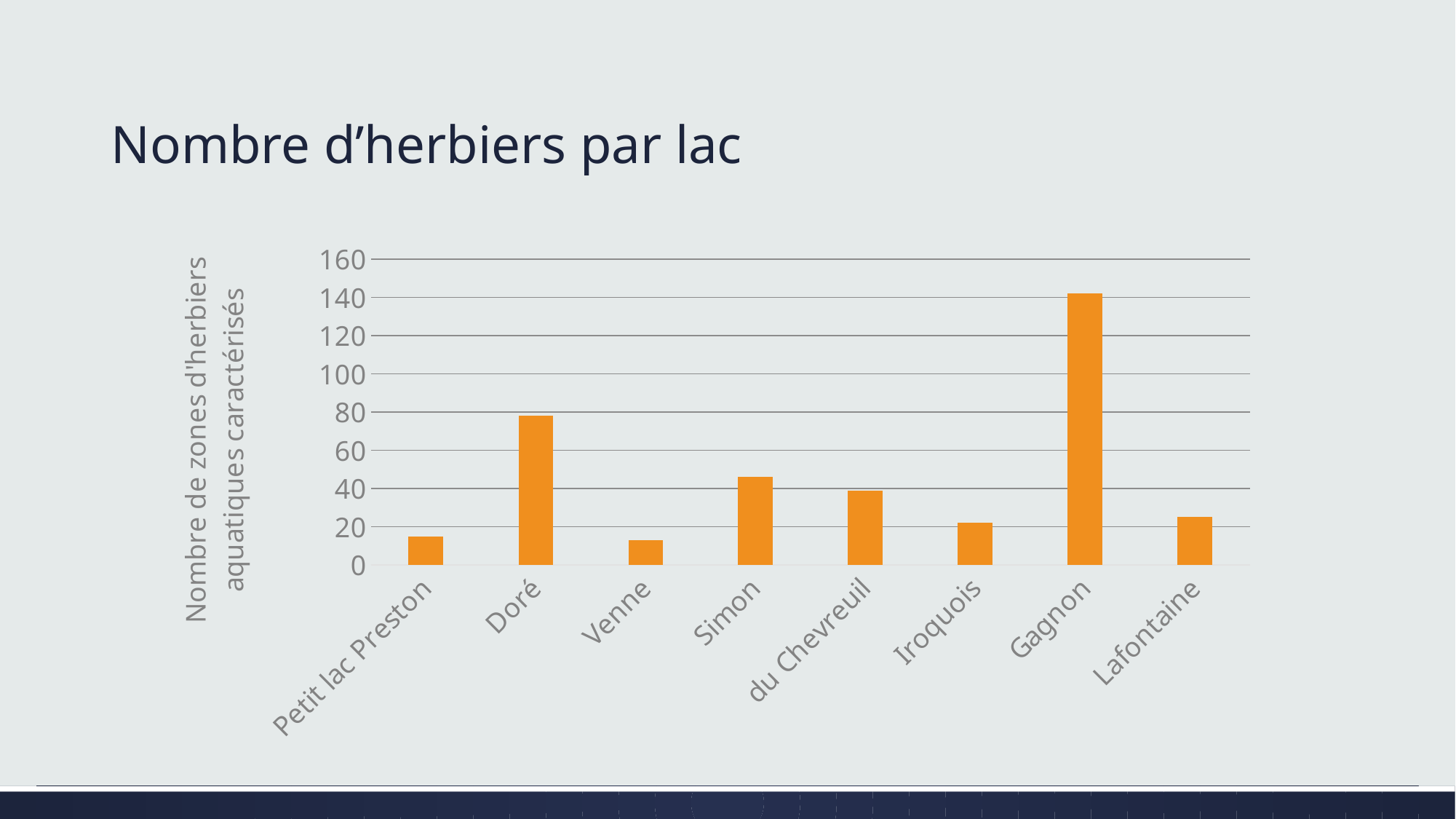
How many lakes are shown on the x axis of the chart? 8 Which lake has the highest number of herbiers? Gagnon Is the value for Gagnon greater or less than 120? greater Is the value for Doré greater or less than 60? greater Is the value for Simon greater or less than 40? greater What kind of chart is shown on the slide? bar chart Which has a higher value, Gagnon or Doré? Gagnon What is the title of the slide? Nombre d’herbiers par lac Which has a higher value, Doré or Simon? Doré